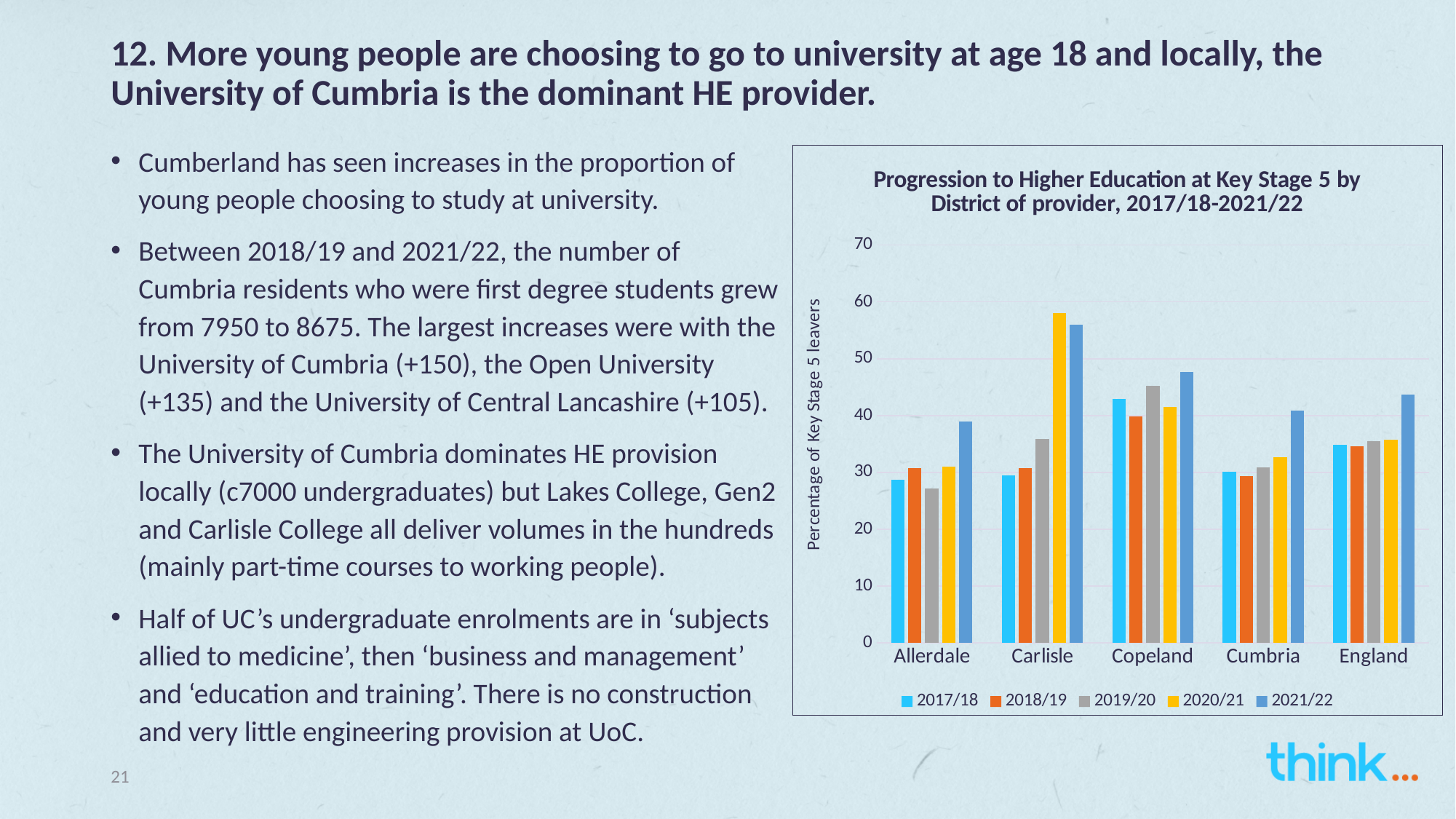
How many series does the chart legend list? 5 Is the 2019/20 value for Allerdale greater or less than 30? less How many districts/categories are shown on the x axis of the chart? 5 Which district has the lowest 2019/20 value in the chart? Allerdale Which is larger: the 2021/22 value for Copeland or the 2021/22 value for Cumbria? Copeland What is the label on the vertical axis of the chart? Percentage of Key Stage 5 leavers Which district has the highest 2020/21 value in the chart? Carlisle What kind of chart is shown on the slide? Bar chart Is the 2020/21 value for Carlisle greater or less than 50? greater Which district has the highest 2021/22 value in the chart? Carlisle Is the 2021/22 value for England greater or less than 40? greater Is the 2021/22 value for Cumbria higher or lower than its 2017/18 value? higher